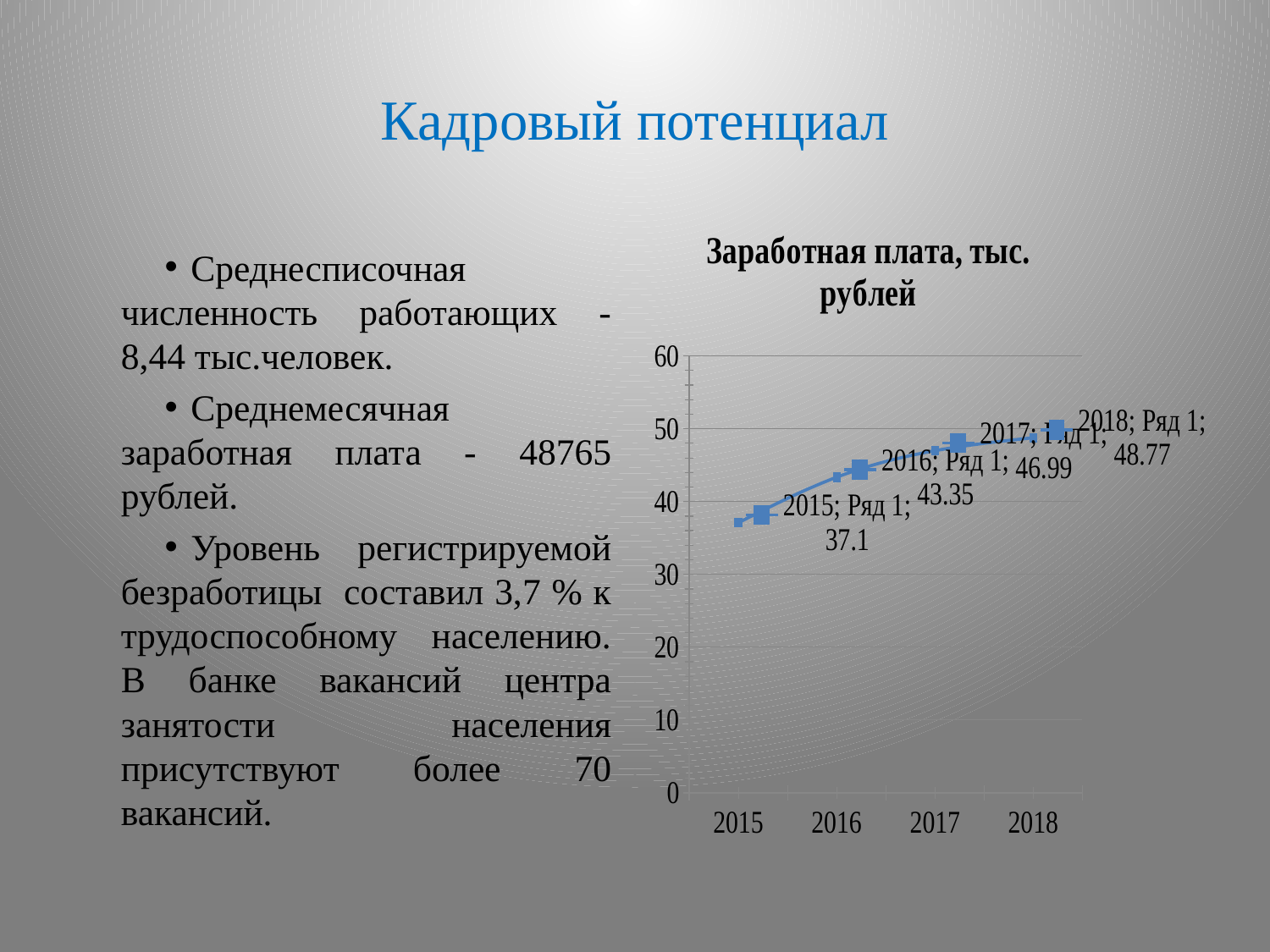
What is the value for 2015? 37.1 Which year has the highest value? 2018 How many years are plotted on the x axis? 4 What is the title of the chart? Заработная плата, тыс. рублей What is the value for 2016? 43.35 What is the value for 2017? 46.99 Which is larger, the value for 2016 or the value for 2017? 2017 What is the value for 2018? 48.77 What type of chart is shown on the slide? line chart What is the difference between the values for 2018 and 2015? 11.67 Do the values rise or fall from 2015 to 2018? rise Which year has the lowest value? 2015